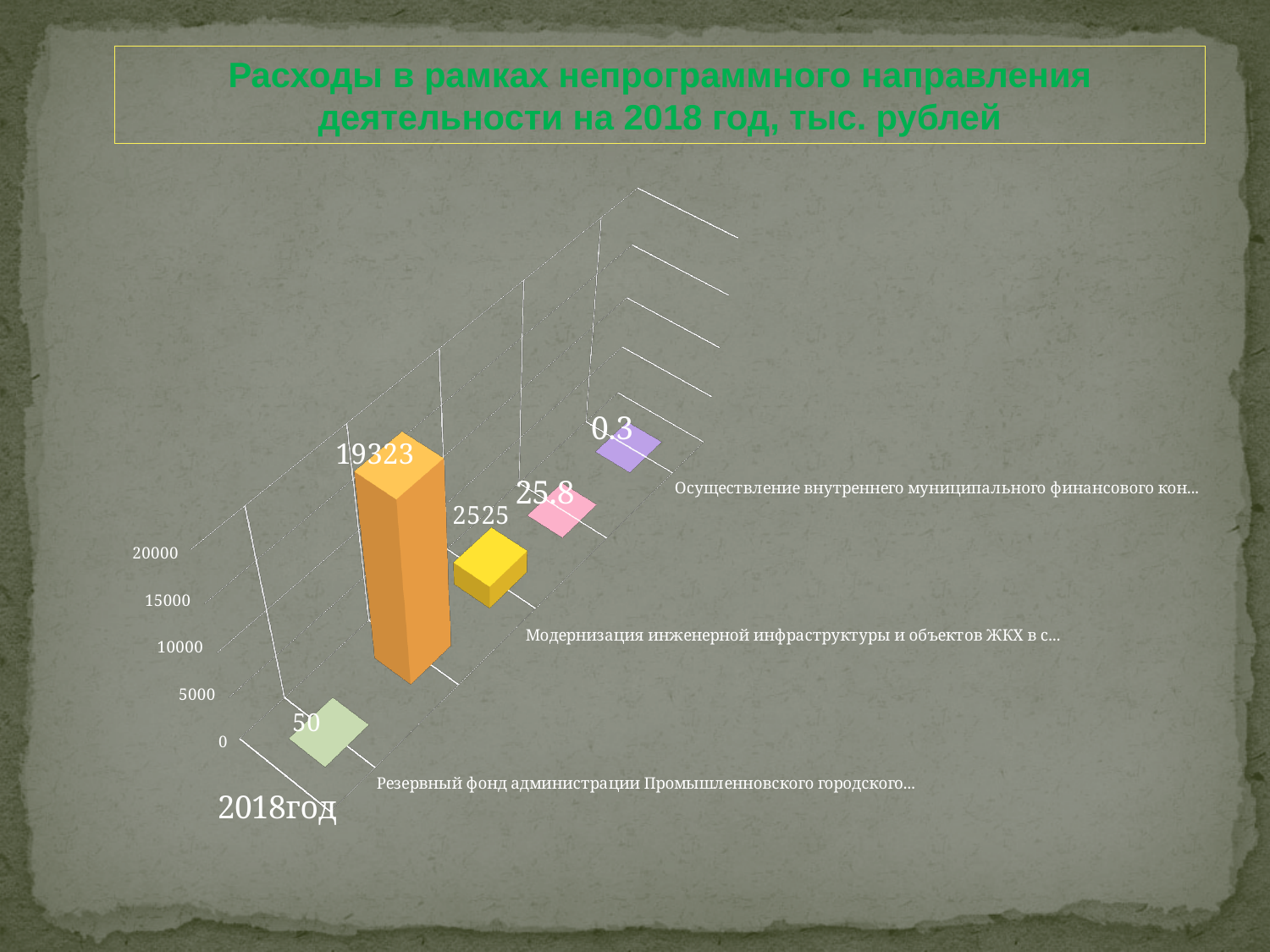
What is the title of the chart on the slide? Расходы в рамках непрограммного направления деятельности на 2018 год, тыс. рублей What is the difference between the value for Модернизация инженерной инфраструктуры и объектов ЖКХ в с... and the value for Резервный фонд администрации Промышленновского городского...? 2475 What is the lowest value shown on the chart? 0.3 What is the highest value shown on the chart? 19323 What kind of chart is shown on the slide? bar chart What label is shown on the horizontal axis of the chart? 2018год What is the value for Резервный фонд администрации Промышленновского городского...? 50 Is the tallest bar's value greater or less than 15000? greater What is the value for Осуществление внутреннего муниципального финансового кон...? 0.3 Which is larger: the value for Резервный фонд администрации Промышленновского городского... or the value for Модернизация инженерной инфраструктуры и объектов ЖКХ в с...? Модернизация инженерной инфраструктуры и объектов ЖКХ в с... How many bars are plotted on the chart? 5 What is the value for Модернизация инженерной инфраструктуры и объектов ЖКХ в с...? 2525